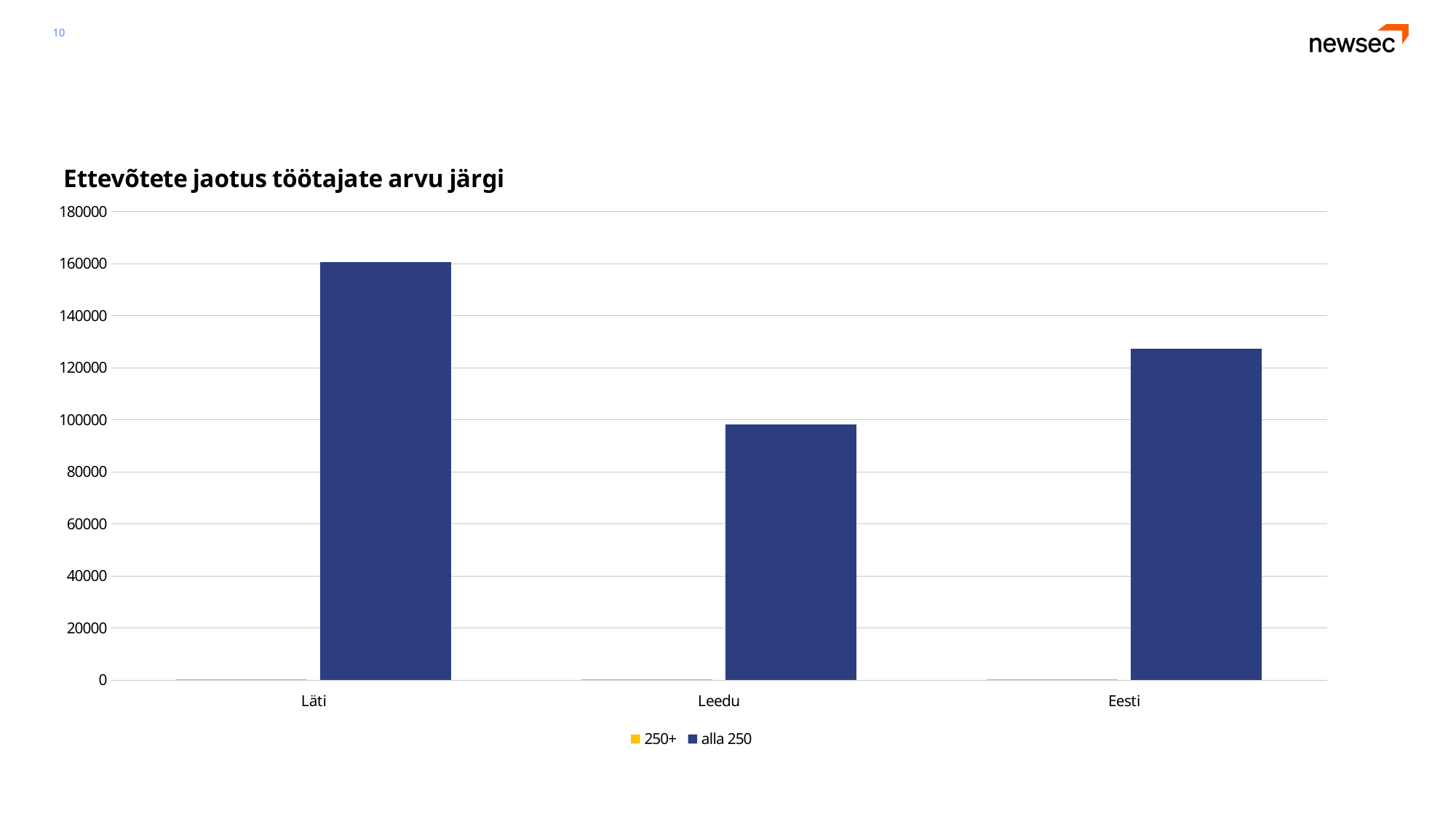
Which is larger for the 'alla 250' series: Eesti or Leedu? Eesti What is the title of the chart? Ettevõtete jaotus töötajate arvu järgi How many series does the legend list? 2 Is the 'alla 250' value for Läti greater or less than 140000? greater Which is larger for the 'alla 250' series: Läti or Eesti? Läti How many countries (categories) are shown on the x axis? 3 Which country has the highest value for the 'alla 250' series? Läti Is the 'alla 250' value for Eesti greater or less than 120000? greater What kind of chart is shown on the slide? bar chart Which colour represents the '250+' series in the legend? yellow Is the 'alla 250' value for Leedu greater or less than 120000? less Which country has the lowest value for the 'alla 250' series? Leedu